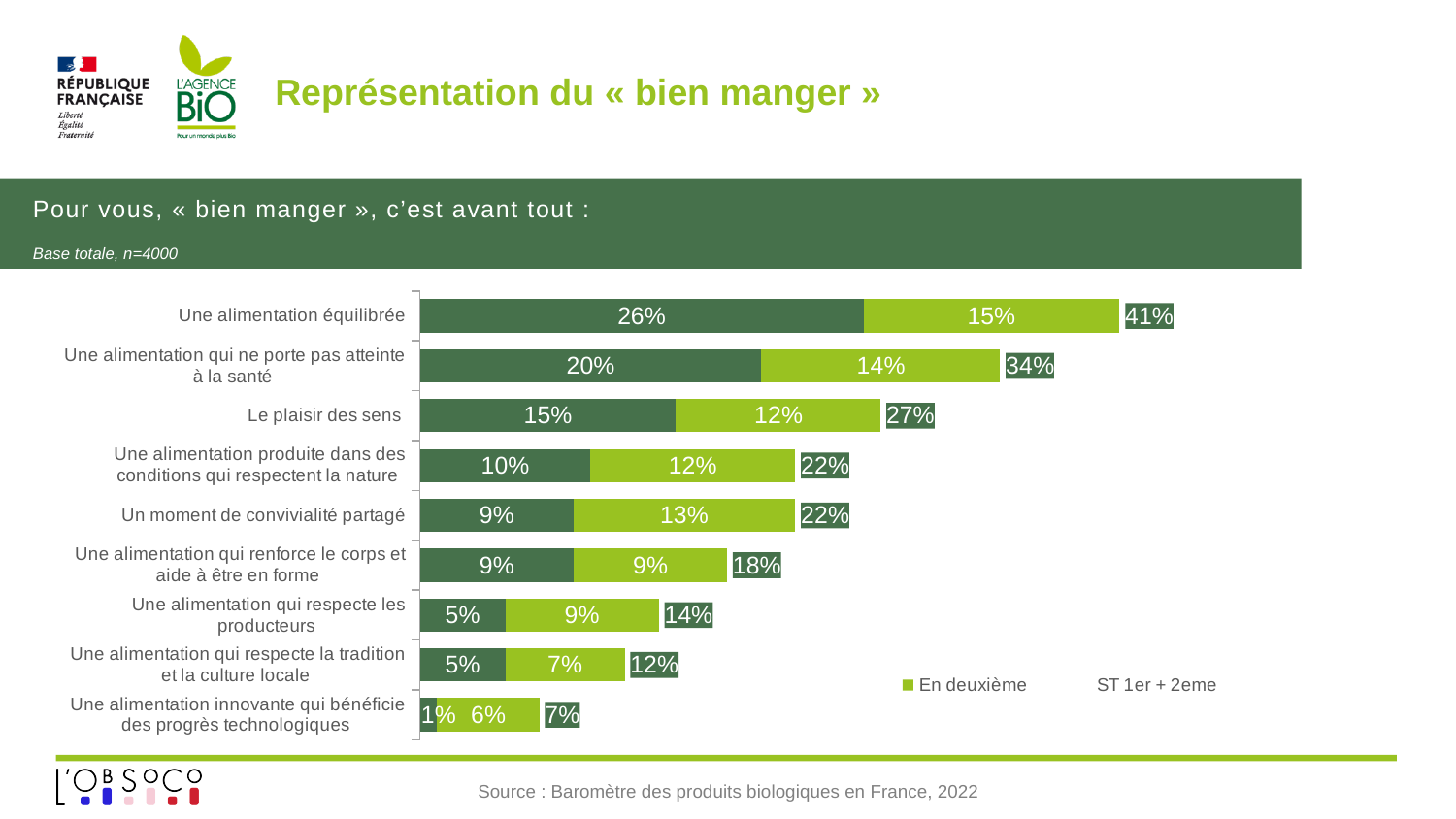
Which is larger: the 'En deuxième' value for 'Un moment de convivialité partagé' or for 'Une alimentation qui renforce le corps et aide à être en forme'? Un moment de convivialité partagé How many categories are shown in the chart? 9 What is the difference between the dark green segment values for 'Une alimentation équilibrée' (26%) and 'Une alimentation qui ne porte pas atteinte à la santé' (20%)? 6 percentage points What colour is used for the 'En deuxième' series in the legend? Light green What is the total of the stacked bar for 'Une alimentation qui respecte les producteurs'? 14% What is the value of the dark green segment for 'Le plaisir des sens'? 15% Which category has the lowest 'ST 1er + 2eme' total? Une alimentation innovante qui bénéficie des progrès technologiques What is the 'ST 1er + 2eme' total shown for 'Une alimentation qui ne porte pas atteinte à la santé'? 34% What is the 'En deuxième' value for 'Une alimentation équilibrée'? 15% Which category has the highest 'ST 1er + 2eme' total? Une alimentation équilibrée What is the 'En deuxième' value for 'Une alimentation innovante qui bénéficie des progrès technologiques'? 6% What kind of chart is shown on the slide? Stacked bar chart